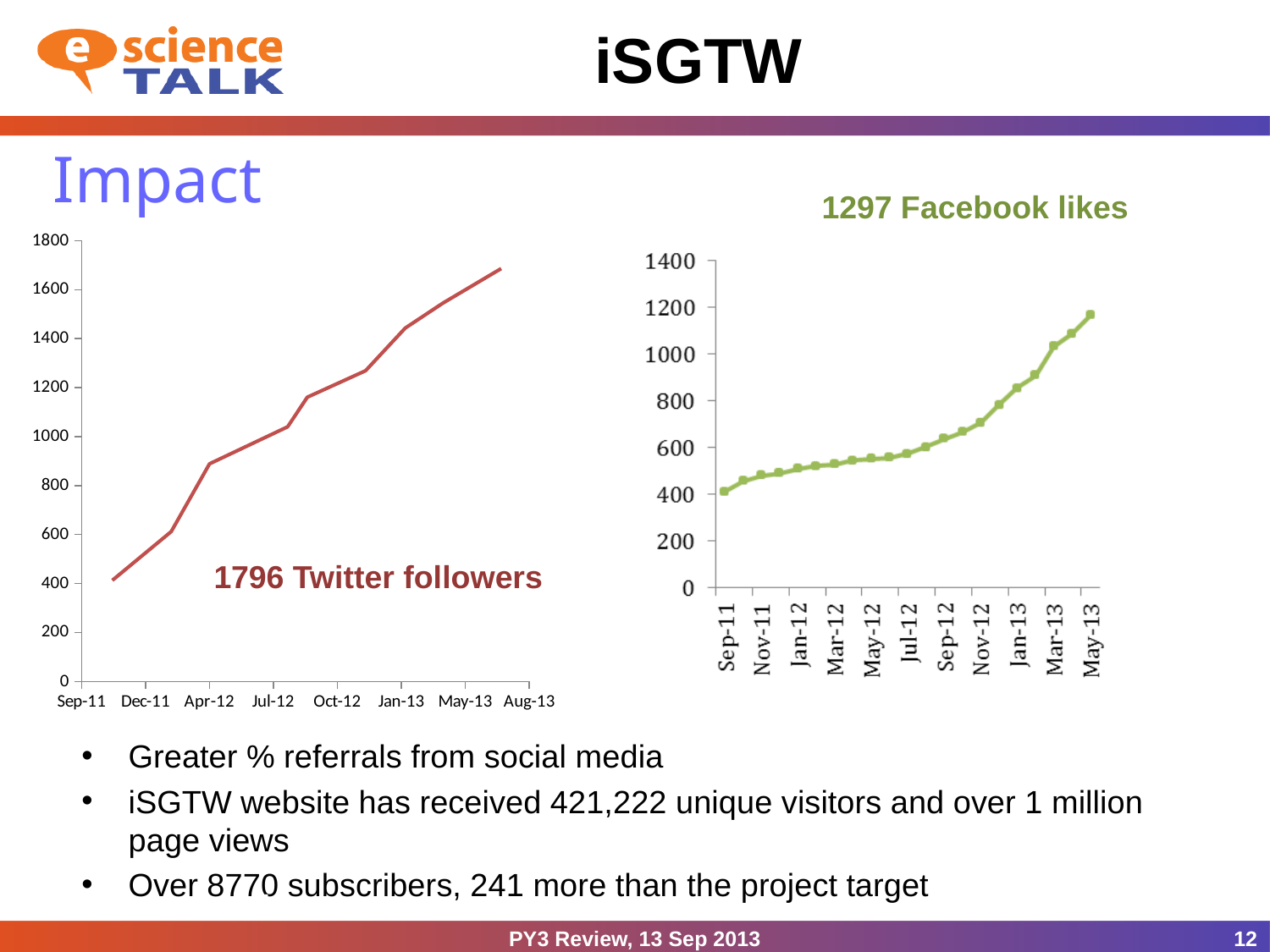
How many date labels are shown on the x axis of the right chart (Facebook likes)? 11 In the right chart (Facebook likes), is the value at Mar-12 greater or less than 600? less What kind of chart is the right chart under the heading "1297 Facebook likes"? line chart In the left chart (Twitter followers), is the value at Aug-13 greater or less than 1600? greater What colour is the line in the left chart (Twitter followers)? red In the left chart (Twitter followers), is the value at Jan-13 greater or less than 1200? greater In the right chart (Facebook likes), do the values rise or fall from Sep-11 to May-13? rise In the left chart (Twitter followers), do the values rise or fall from Sep-11 to Aug-13? rise What kind of chart is the left chart labelled "1796 Twitter followers"? line chart